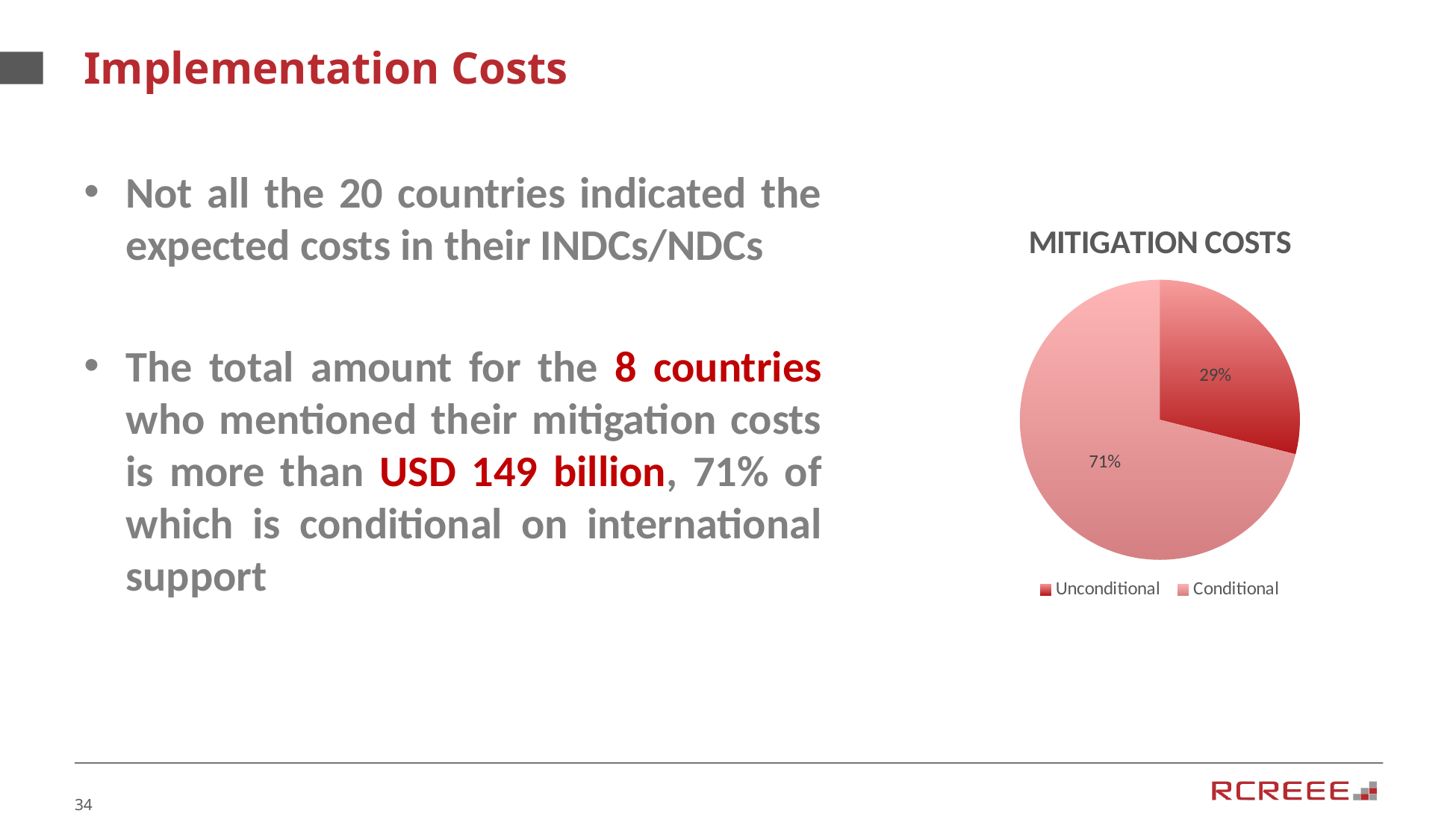
How many entries does the legend list? 2 What share of mitigation costs is Conditional? 71% Which slice of the pie is the largest? Conditional How many slices does the pie chart have? 2 Which legend entry is shown in the darker red colour? Unconditional What kind of chart is shown on the slide? pie chart What is the difference in percentage points between the Conditional and Unconditional shares? 42 Which is larger, the Conditional share or the Unconditional share? Conditional What is the title of the chart? MITIGATION COSTS What share of mitigation costs is Unconditional? 29% Which slice of the pie is the smallest? Unconditional